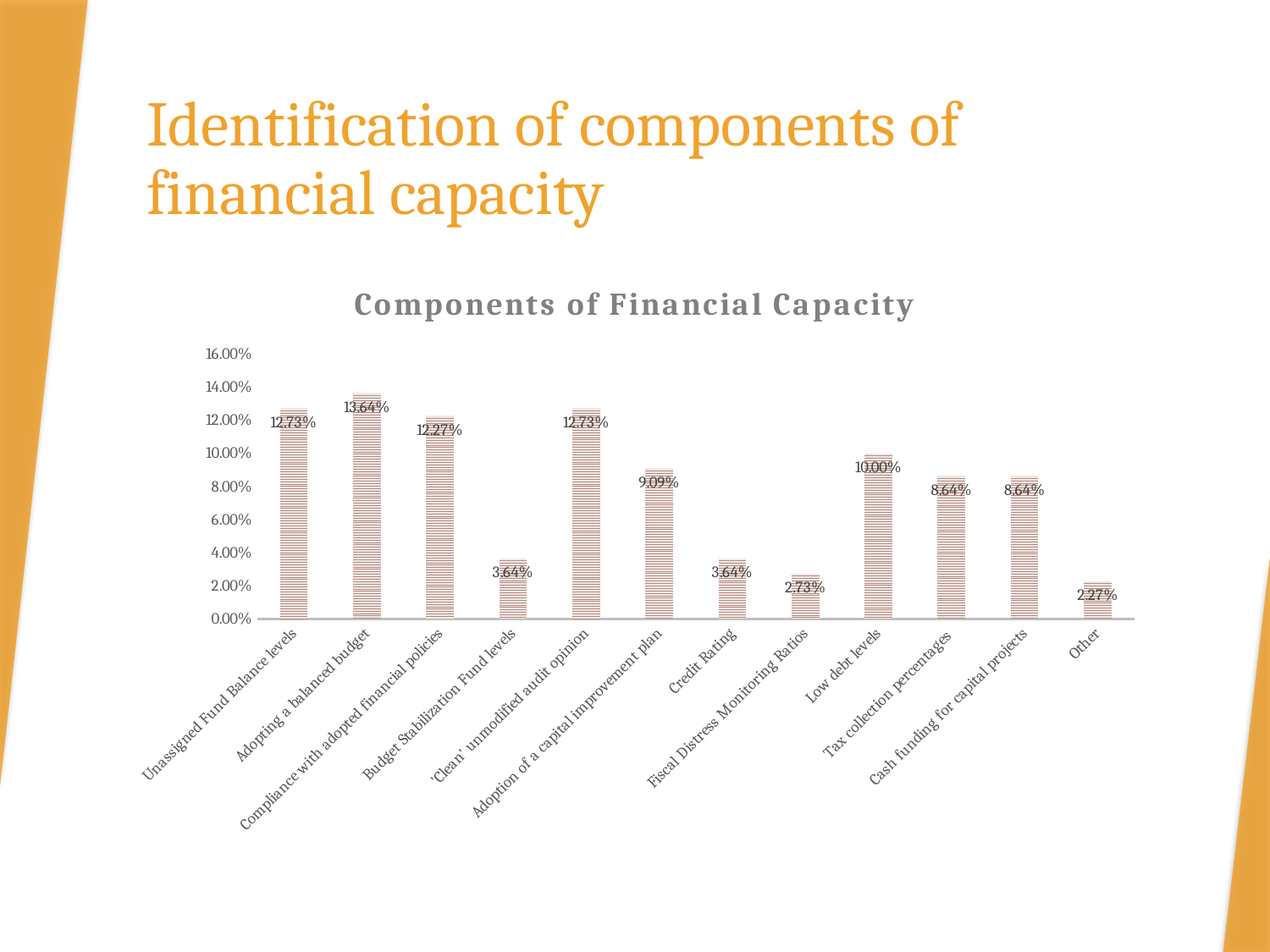
What kind of chart is shown on the slide? Bar chart What is the value for Adoption of a capital improvement plan? 9.09% What is the value for Fiscal Distress Monitoring Ratios? 2.73% Which is larger, the value for Low debt levels or the value for Tax collection percentages? Low debt levels What is the value for Adopting a balanced budget? 13.64% Which category has the highest value? Adopting a balanced budget What is the value for Low debt levels? 10.00% Which category has the lowest value? Other Is the value for Credit Rating greater or less than 4.00%? less What is the difference between the values for Adopting a balanced budget and Compliance with adopted financial policies? 1.37% How many categories are shown on the x axis? 12 What is the title of the chart? Components of Financial Capacity